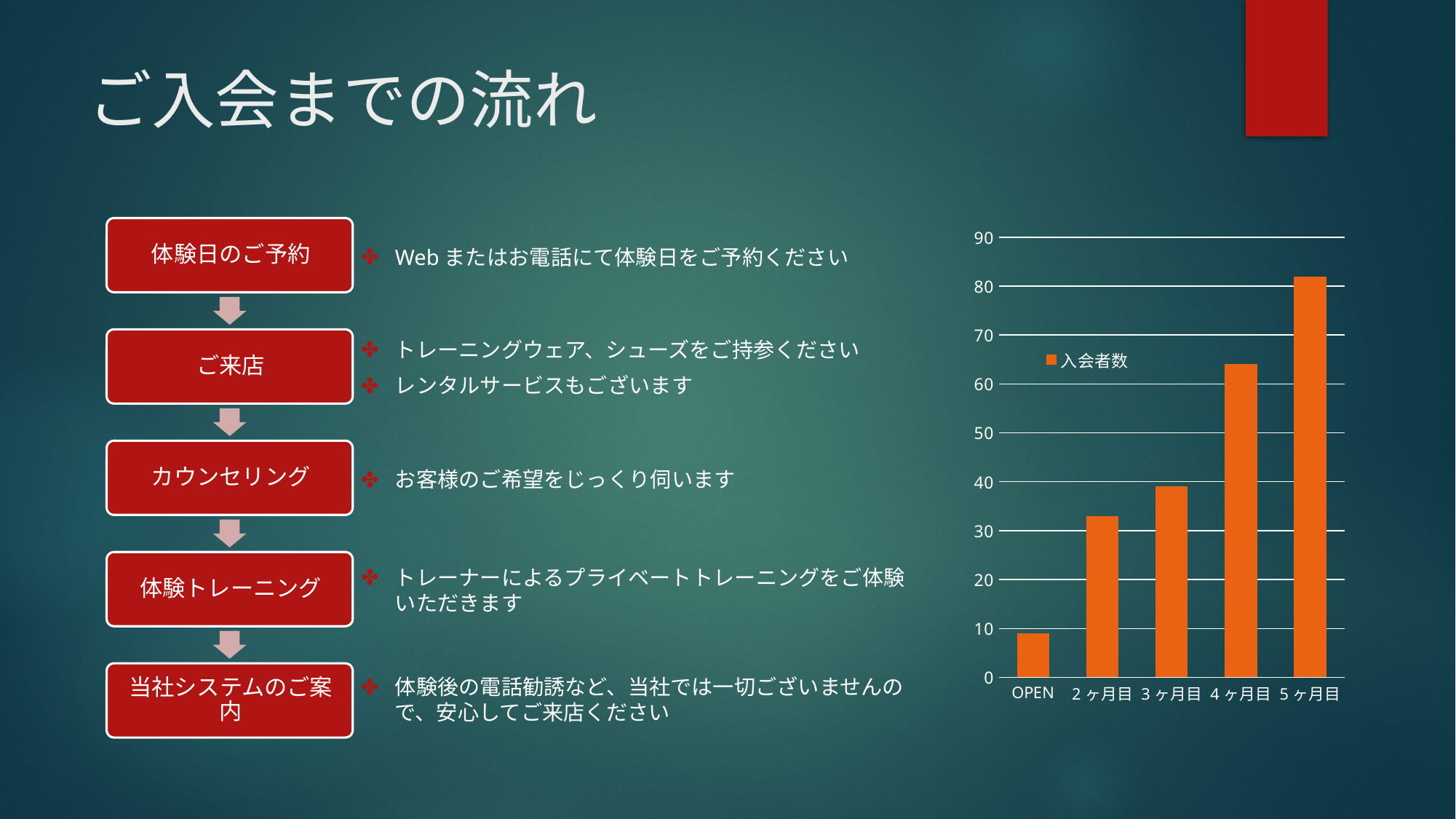
How many categories are plotted along the x axis of the chart? 5 Which category has the highest value in the chart? 5ヶ月目 Which is larger, the value for 4ヶ月目 or the value for 2ヶ月目? 4ヶ月目 Which category has the lowest value in the chart? OPEN Is the value for 5ヶ月目 greater or less than 70? greater How many series does the chart's legend list? 1 What is the name of the series shown in the chart's legend? 入会者数 Is the value for 2ヶ月目 greater or less than 30? greater Is the value for OPEN greater or less than 20? less What kind of chart is shown on the right side of the slide? bar chart Do the values in the chart rise or fall from OPEN to 5ヶ月目? rise